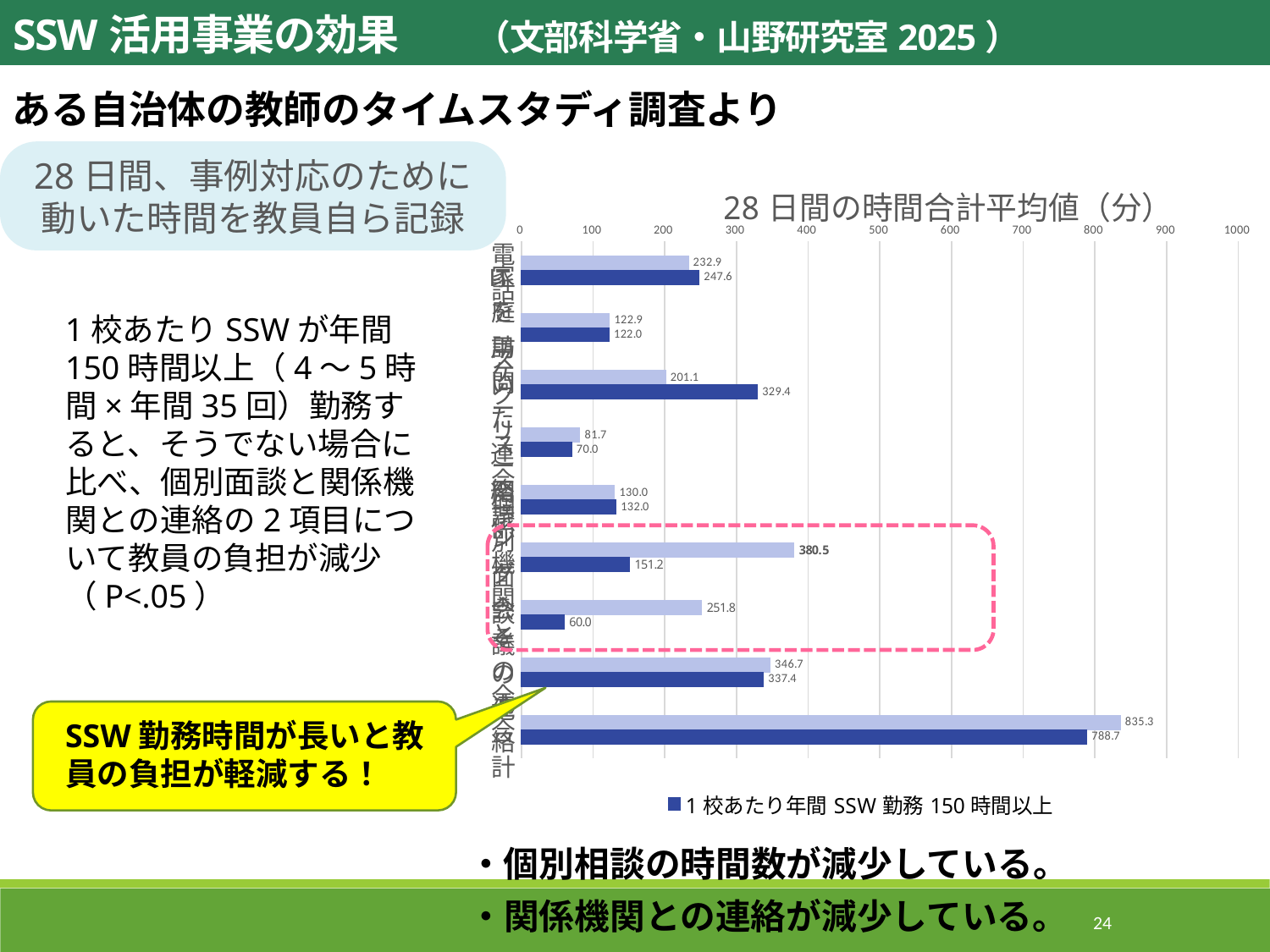
What is the title of the chart? 28日間の時間合計平均値（分） What is the difference between the light blue and dark blue bars for 合計? 46.6 For 合計, which bar is larger, the light blue or the dark blue one? light blue What is the value of the dark blue bar for 合計? 788.7 What is the largest value labelled on the chart? 835.3 How many categories (pairs of bars) does the chart show? 9 What is the value of the light blue bar for 合計? 835.3 What kind of chart is shown on the slide? bar chart What is the legend entry shown below the chart? 1校あたり年間SSW勤務150時間以上 What is the smallest value labelled on the chart? 60.0 In the upper pair of bars inside the pink dashed box, what is the difference between the light blue value (380.5) and the dark blue value (151.2)? 229.3 How many series does the legend list? 1